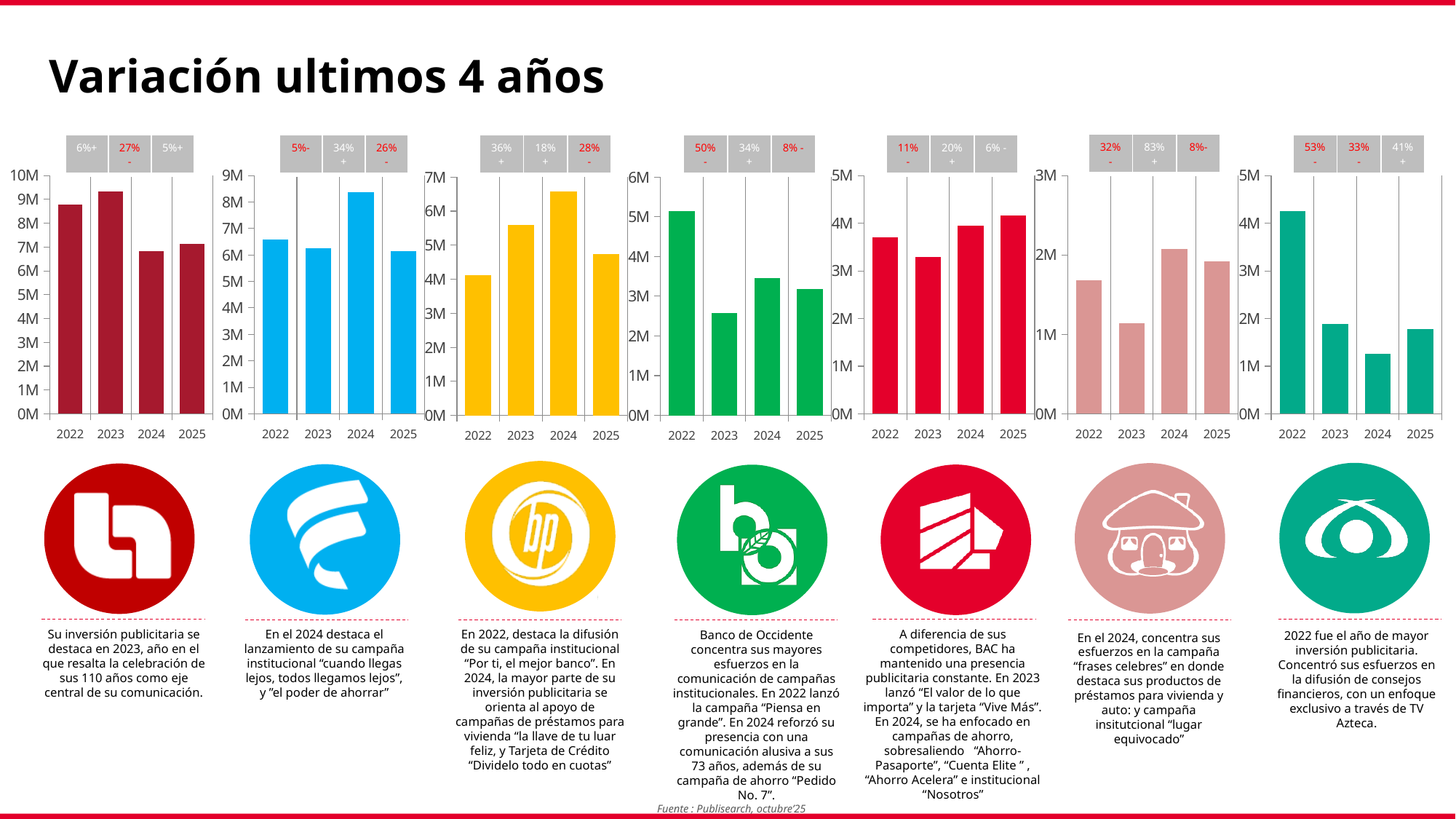
In the third chart from the left (yellow), which year has the lowest bar? 2022 How many years (categories) does the leftmost chart show? 4 What kind of chart is the leftmost chart on the slide? bar chart In the sixth chart from the left (pink), which is larger, the value for 2024 or the value for 2023? 2024 In the leftmost (dark red) chart, which year has the highest bar? 2023 In the leftmost (dark red) chart, is the value for 2022 greater or less than 8M? greater In the fourth chart from the left (green), which year has the highest bar? 2022 In the fourth chart from the left (green), is the value for 2023 greater or less than 3M? less How many bar charts are shown on the slide? 7 In the rightmost (teal) chart, is the value for 2022 greater or less than 4M? greater In the fifth chart from the left (red), which year has the lowest bar? 2023 In the second chart from the left (blue), which year has the highest bar? 2024